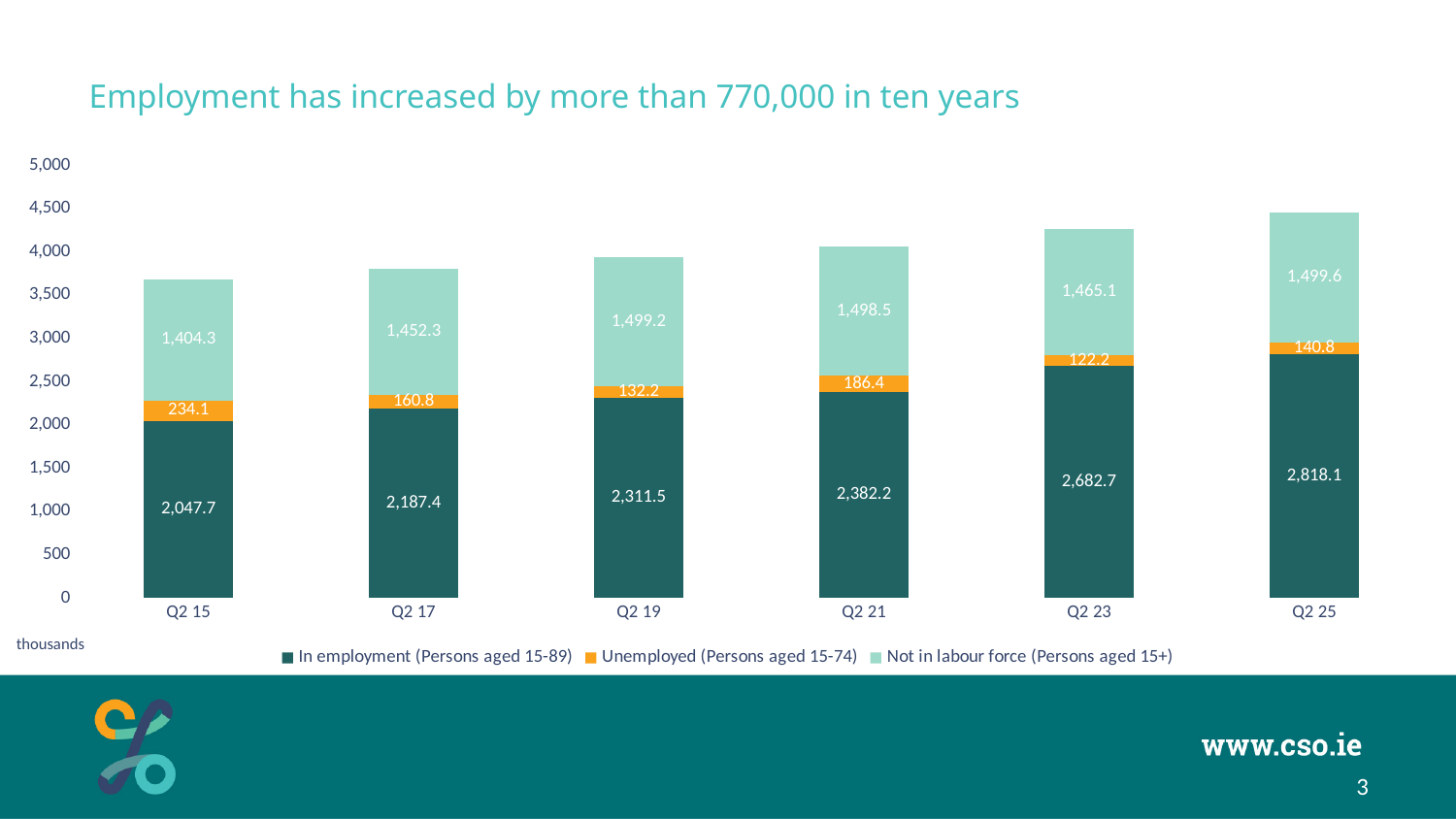
In which quarter is the Unemployed value lowest? Q2 23 By how much did the In employment value increase from Q2 15 to Q2 25? 770.4 What is the value for In employment in Q2 15? 2,047.7 Which is larger, the Unemployed value in Q2 17 or in Q2 19? Q2 17 What kind of chart is shown on the slide? Stacked bar chart What is the total of the stacked bar for Q2 23? 4,270.0 What is the value for Unemployed in Q2 21? 186.4 Is the total height of the Q2 25 stacked bar greater or less than 4,000? greater What is the value for Not in labour force in Q2 25? 1,499.6 How many series does the legend list? 3 In which quarter is the In employment value highest? Q2 25 How many quarters are shown on the x axis? 6